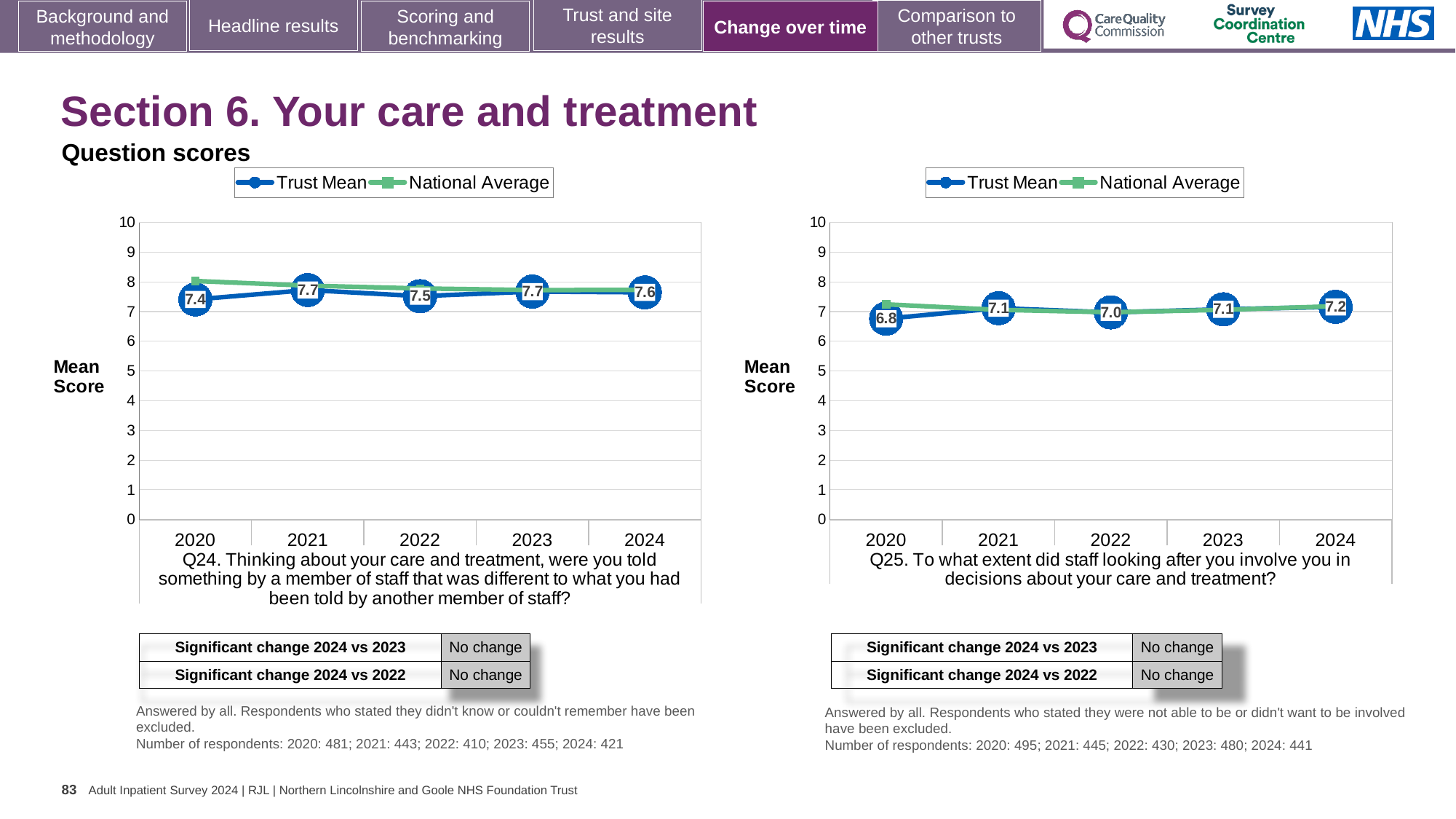
How many series does the legend of the Q25 chart (right) list? 2 How many years are plotted on the Q24 chart (left)? 5 On the Q24 chart (left), what is the Trust Mean score for 2022? 7.5 On the Q24 chart (left), which year has the larger Trust Mean score, 2021 or 2022? 2021 On the Q24 chart (left), in which year is the Trust Mean score lowest? 2020 On the Q25 chart (right), what is the difference between the Trust Mean scores for 2024 and 2020? 0.4 On the Q25 chart (right), in which year is the Trust Mean score lowest? 2020 On the Q25 chart (right), in which year is the Trust Mean score highest? 2024 On the Q25 chart (right), what is the Trust Mean score for 2024? 7.2 On the Q24 chart (left), what is the Trust Mean score for 2020? 7.4 On the Q25 chart (right), is the National Average value for 2020 greater or less than 7? greater What type of chart is used for the Q25 chart (right)? Line chart